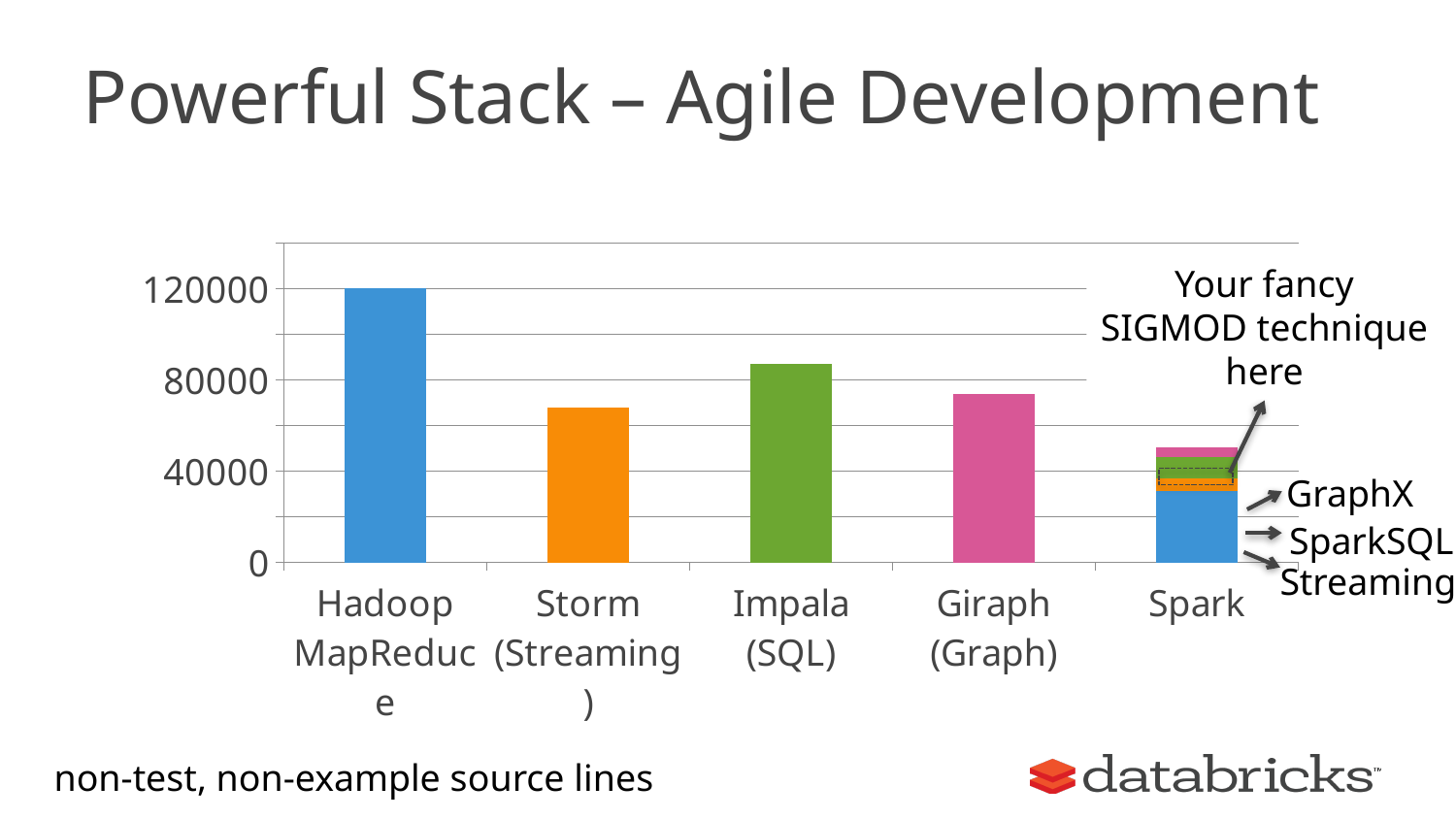
Which category has the shortest bar in the chart? Spark Which is larger, the value for Impala (SQL) or the value for Storm (Streaming)? Impala (SQL) Is the total height of the Spark bar greater or less than 40000? greater Is the value for Storm (Streaming) greater or less than 80000? less According to the note at the bottom of the slide, what do the bar values measure? non-test, non-example source lines Is the value for Giraph (Graph) greater or less than 80000? less What is the value for Hadoop MapReduce in the chart? 120000 Which category has the tallest bar in the chart? Hadoop MapReduce How many categories are plotted on the x axis of the chart? 5 What kind of chart is shown on the slide? bar chart Which is larger, the value for Impala (SQL) or the value for Giraph (Graph)? Impala (SQL)